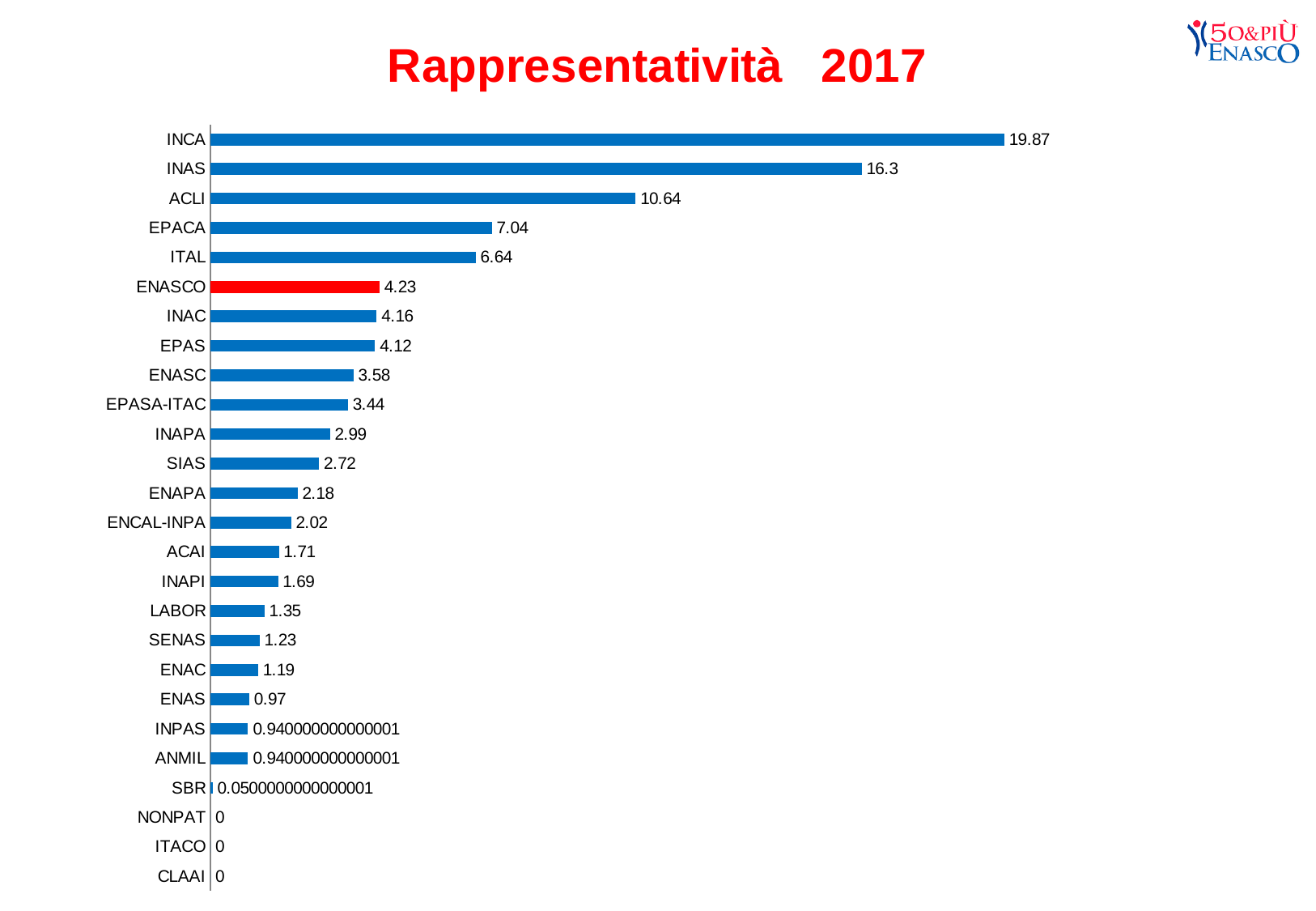
How many categories are shown in the chart? 26 What is the difference between the values for INCA and INAS? 3.57 What is the difference between the values for ACLI and EPACA? 3.6 Which category has the highest value? INCA Which category's bar is coloured red? ENASCO What is the value for LABOR? 1.35 Which is larger, the value for EPACA or the value for ITAL? EPACA What is the value for ENASCO? 4.23 What is the value for EPASA-ITAC? 3.44 Which is larger, the value for ENASCO or the value for ENASC? ENASCO What is the value for INCA? 19.87 What kind of chart is shown on the slide? Bar chart